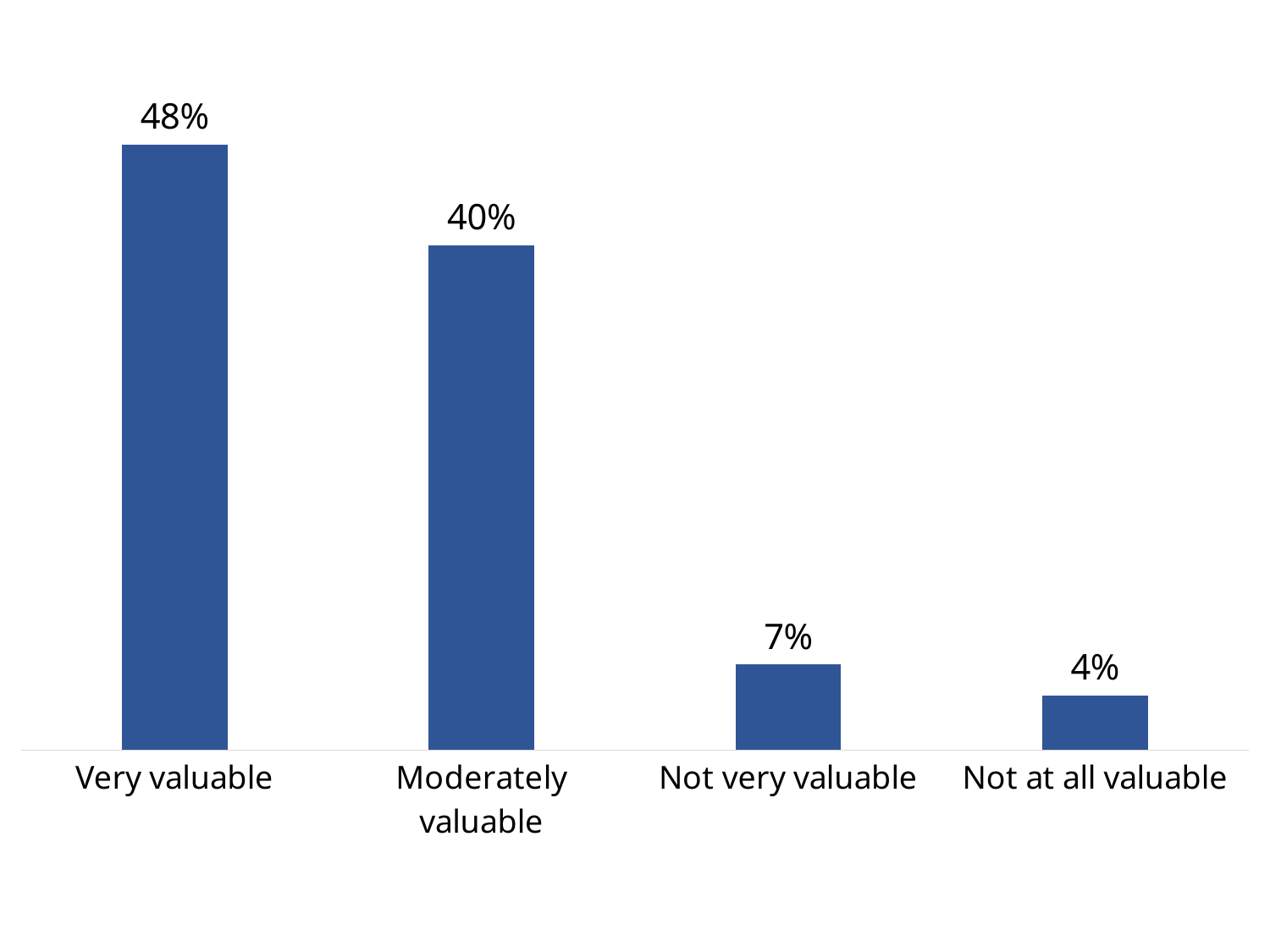
What is the difference between the values for Very valuable and Moderately valuable? 8% What is the value for Not at all valuable? 4% Which is larger, the value for Moderately valuable or the value for Not very valuable? Moderately valuable What is the value for Moderately valuable? 40% What is the value for Not very valuable? 7% How many categories are shown in the chart? 4 What is the value for Very valuable? 48% Do the values rise or fall from left to right across the categories? Fall Which category has the highest value? Very valuable Which category has the lowest value? Not at all valuable What is the difference between the values for Not very valuable and Not at all valuable? 3% What kind of chart is this? Bar chart